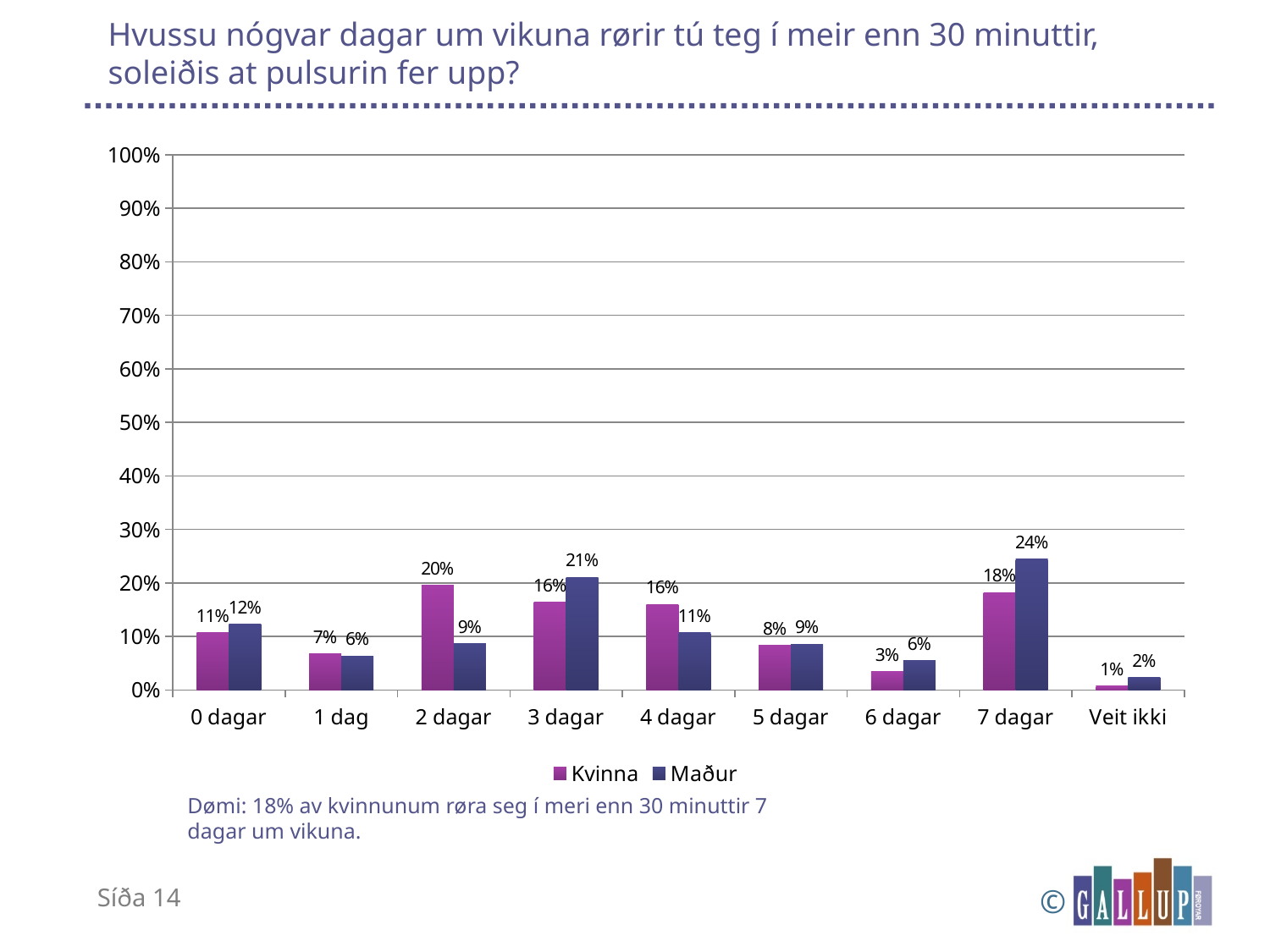
What is the value for Kvinna at 2 dagar? 20% Is the value for Maður at 3 dagar greater or less than 20%? greater Which category has the highest value for the Maður series? 7 dagar What is the value for Maður at 7 dagar? 24% At 4 dagar, which series has the larger value, Kvinna or Maður? Kvinna How many categories are shown on the x axis? 9 What is the value for Kvinna at 6 dagar? 3% Which series is shown in the darker purple colour? Maður How many series does the legend list? 2 What kind of chart is shown on the slide? Bar chart Which category has the lowest value for the Kvinna series? Veit ikki What is the difference between the Maður and Kvinna values at 2 dagar? 11%